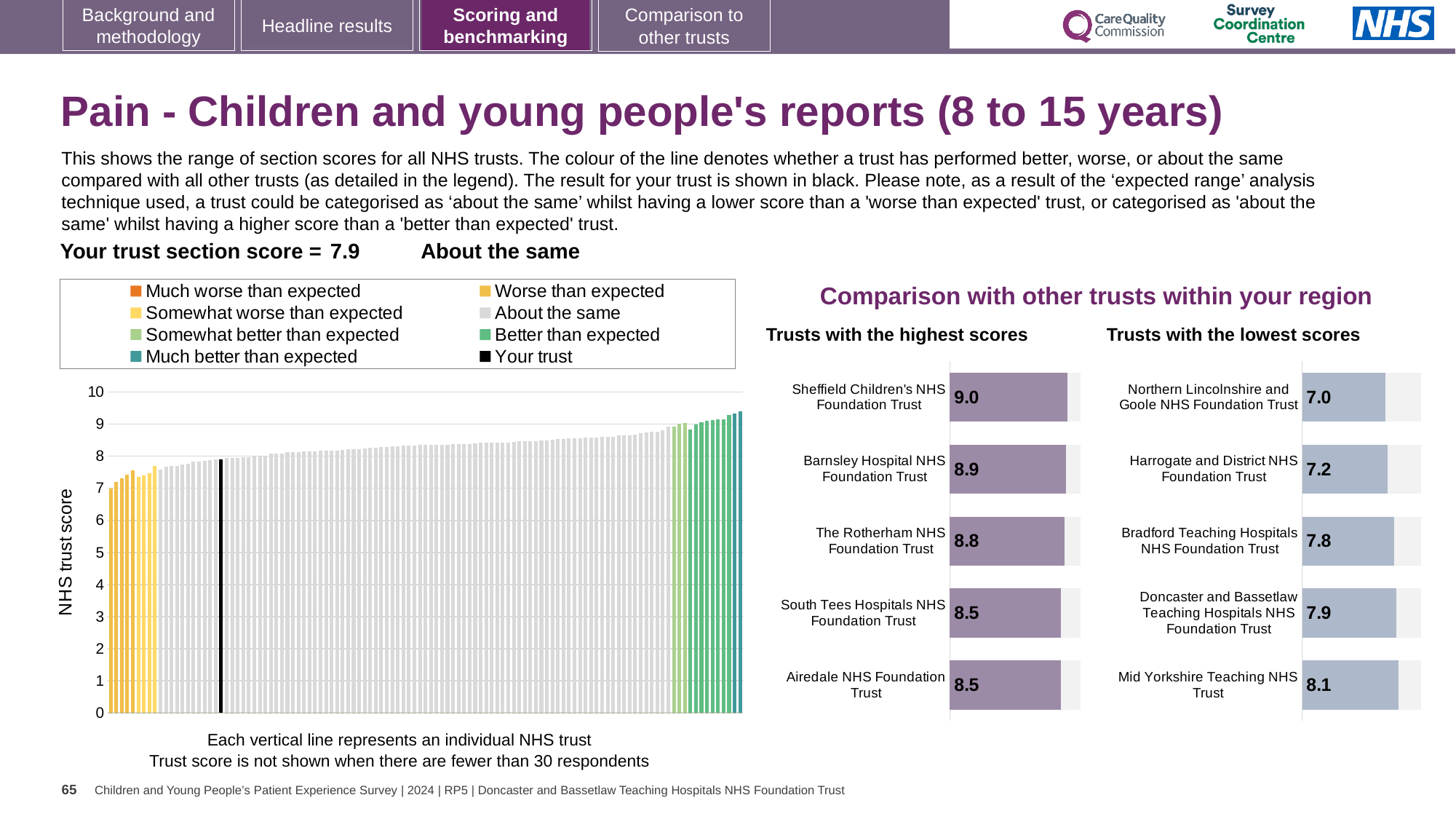
How many entries does the legend of the large chart on the left list? 8 In the 'Trusts with the lowest scores' chart, which trust has the lowest score? Northern Lincolnshire and Goole NHS Foundation Trust In the 'Trusts with the lowest scores' chart, which has the higher score: Bradford Teaching Hospitals NHS Foundation Trust or Harrogate and District NHS Foundation Trust? Bradford Teaching Hospitals NHS Foundation Trust In the 'Trusts with the lowest scores' chart, what is the difference between the scores of Mid Yorkshire Teaching NHS Trust and Northern Lincolnshire and Goole NHS Foundation Trust? 1.1 In the 'Trusts with the lowest scores' chart, what is the score for Doncaster and Bassetlaw Teaching Hospitals NHS Foundation Trust? 7.9 In the 'Trusts with the lowest scores' chart, what is the score for Harrogate and District NHS Foundation Trust? 7.2 In the 'Trusts with the highest scores' chart, which has the higher score: The Rotherham NHS Foundation Trust or South Tees Hospitals NHS Foundation Trust? The Rotherham NHS Foundation Trust In the 'Trusts with the highest scores' chart, which trust has the highest score? Sheffield Children's NHS Foundation Trust How many trusts are listed in the 'Trusts with the highest scores' chart? 5 In the 'Trusts with the highest scores' chart, what is the difference between the scores of Sheffield Children's NHS Foundation Trust and Barnsley Hospital NHS Foundation Trust? 0.1 In the 'Trusts with the highest scores' chart, what is the score for Sheffield Children's NHS Foundation Trust? 9.0 What kind of chart is the large chart on the left showing NHS trust scores? Bar chart